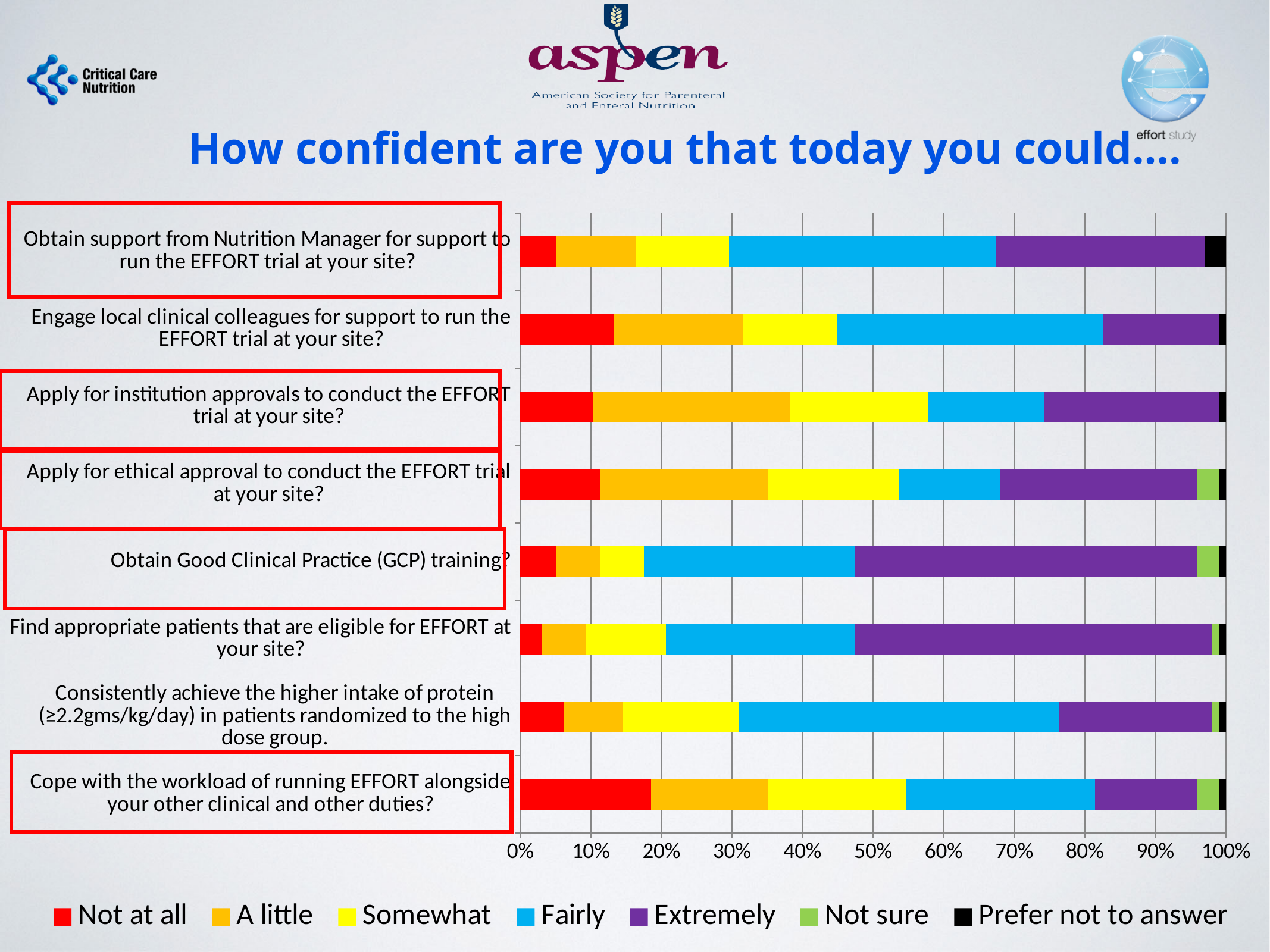
Is the 'Not at all' share for 'Cope with the workload of running EFFORT alongside your other clinical and other duties?' greater or less than 10%? greater What kind of chart is shown on the slide? Stacked bar chart Is the 'Not at all' share for 'Find appropriate patients that are eligible for EFFORT at your site?' greater or less than 10%? less Which category has the largest 'A little' share? Apply for institution approvals to conduct the EFFORT trial at your site? How many response categories does the legend list? 7 What is the title of the chart? How confident are you that today you could.... Which colour represents the 'Extremely' response in the chart? Purple Which category has the largest 'Not at all' share? Cope with the workload of running EFFORT alongside your other clinical and other duties? Which category has the largest 'Fairly' share? Consistently achieve the higher intake of protein (≥2.2gms/kg/day) in patients randomized to the high dose group. Is the 'Extremely' share for 'Obtain Good Clinical Practice (GCP) training?' greater or less than 40%? greater How many survey questions (categories) are plotted on the chart? 8 Which has the larger 'Not at all' share: 'Engage local clinical colleagues for support to run the EFFORT trial at your site?' or 'Obtain support from Nutrition Manager for support to run the EFFORT trial at your site?'? Engage local clinical colleagues for support to run the EFFORT trial at your site?